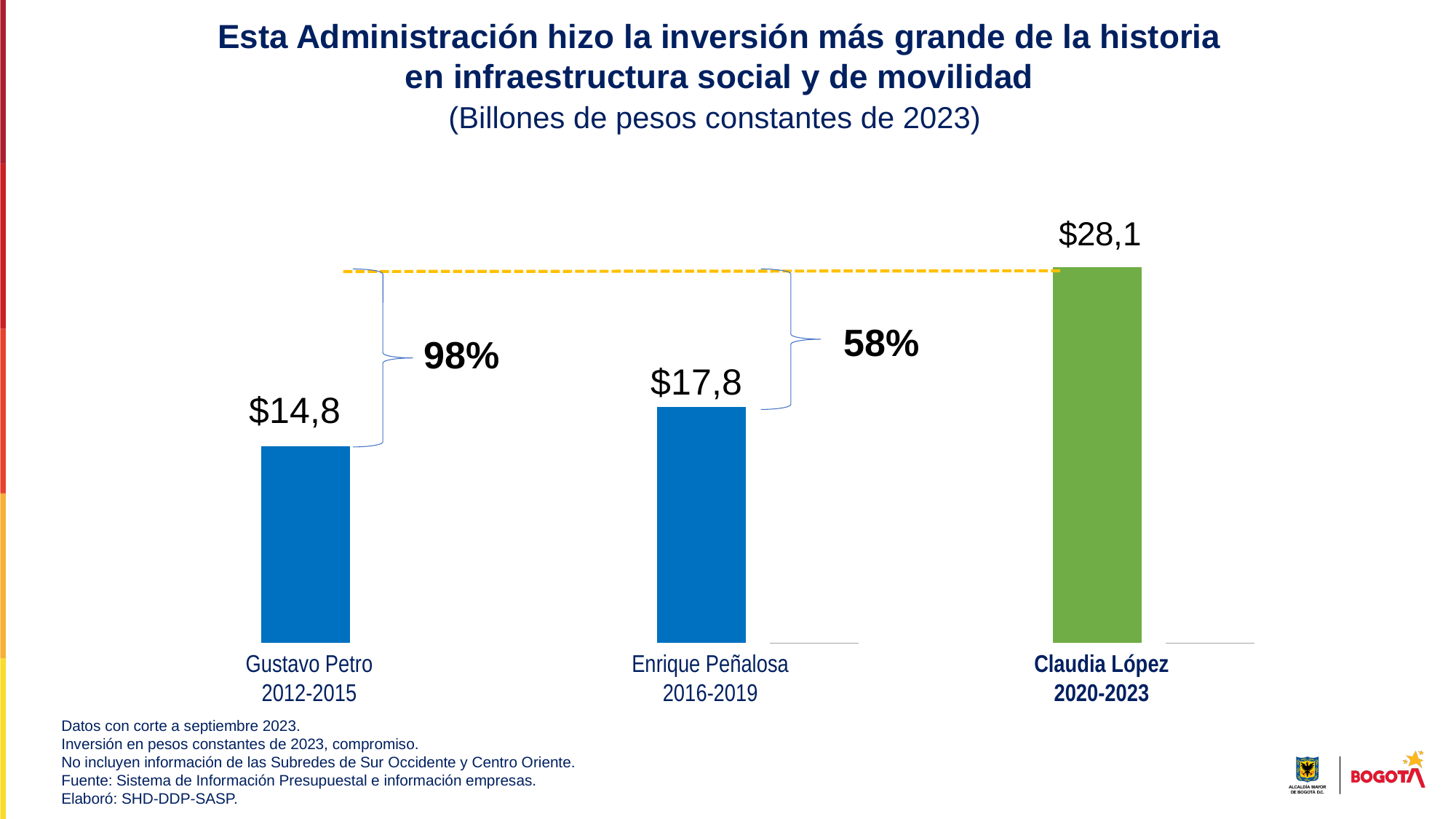
What is the investment value shown for Claudia López 2020-2023? $28,1 What is the investment value shown for Enrique Peñalosa 2016-2019? $17,8 What is the difference between the values for Claudia López 2020-2023 and Enrique Peñalosa 2016-2019? $10,3 Which administration has the highest investment value? Claudia López 2020-2023 Which administration has the lowest investment value? Gustavo Petro 2012-2015 How many administrations (bars) are shown in the chart? 3 What kind of chart is shown on the slide? Bar chart What percentage increase is labelled between Gustavo Petro 2012-2015 and Claudia López 2020-2023? 98% What is the investment value shown for Gustavo Petro 2012-2015? $14,8 What is the difference between the values for Enrique Peñalosa 2016-2019 and Gustavo Petro 2012-2015? $3,0 Do the values rise or fall from left to right across the administrations? Rise Which is larger, the value for Gustavo Petro 2012-2015 or Enrique Peñalosa 2016-2019? Enrique Peñalosa 2016-2019